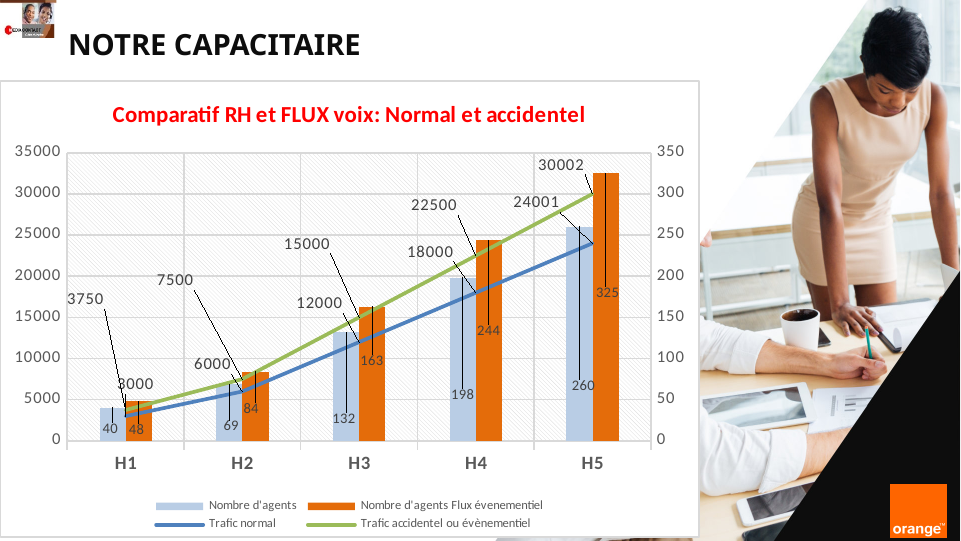
Which category has the highest value for Trafic accidentel ou évènementiel? H5 What is the value of Nombre d'agents Flux évènementiel for H5? 325 How many categories are shown on the x axis? 5 What is the title of the chart? Comparatif RH et FLUX voix: Normal et accidentel What is the value of Trafic normal for H4? 18000 What is the value of Trafic accidentel ou évènementiel for H2? 7500 What is the value of Nombre d'agents for H3? 132 How many series does the legend list? 4 What is the difference between Nombre d'agents Flux évènementiel and Nombre d'agents for H4? 46 Which category has the lowest value for Nombre d'agents? H1 Does Trafic normal rise or fall from H1 to H5? rise Which is larger for H3: Trafic normal or Trafic accidentel ou évènementiel? Trafic accidentel ou évènementiel